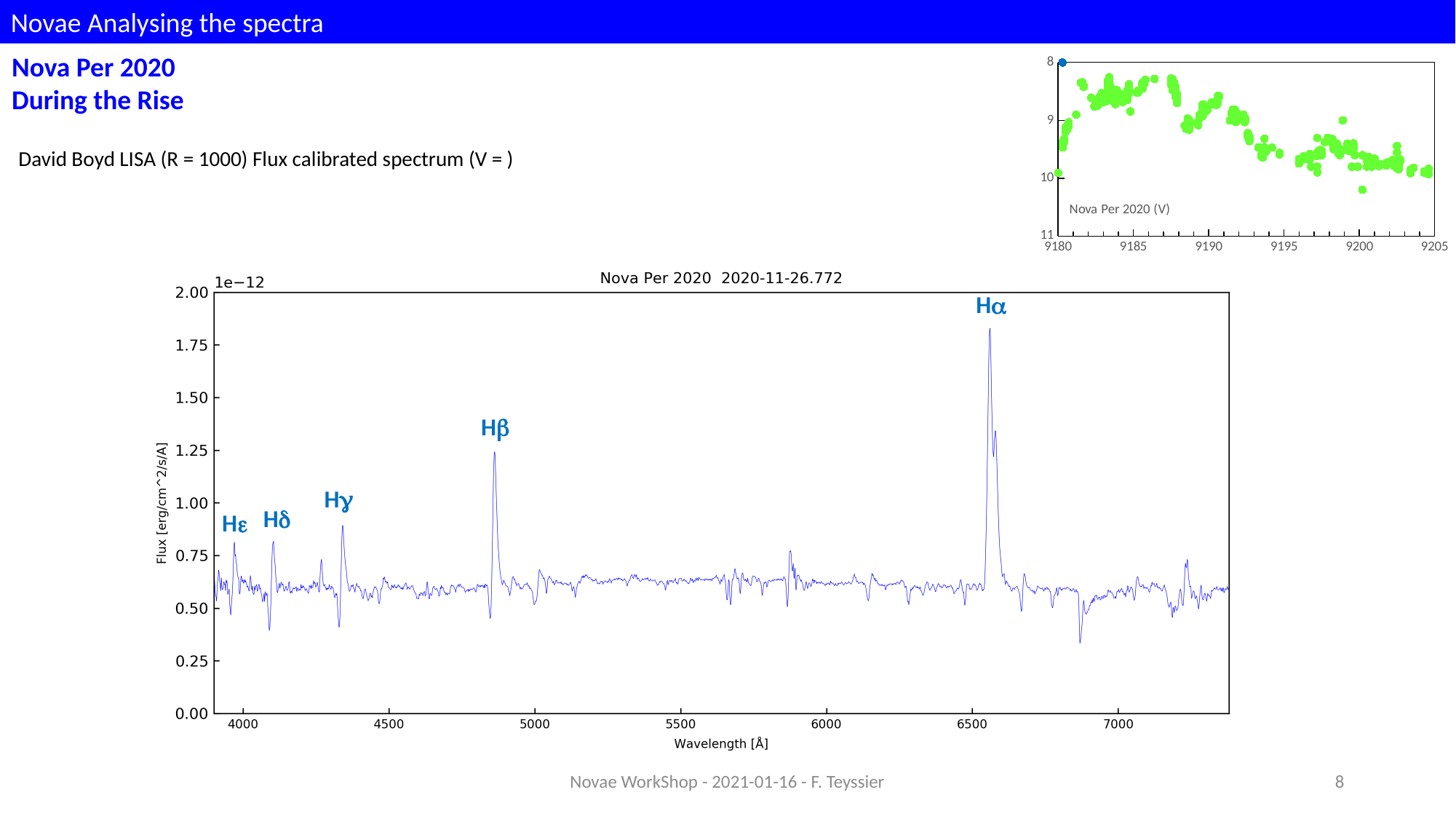
In the spectrum chart, is the peak flux of Hβ greater or less than 1.00 (×1e−12)? greater What type of chart is the small chart in the top right corner of the slide? scatter chart In the spectrum chart, is the peak flux of Hα greater or less than 1.50 (×1e−12)? greater What is the title of the large spectrum chart? Nova Per 2020 2020-11-26.772 What type of chart is the large chart at the bottom of the slide? line chart In the spectrum chart, what is the label of the x axis? Wavelength [Å] In the spectrum chart, which has the higher peak flux, Hβ or Hγ? Hβ In the spectrum chart, how many emission lines are labelled with blue text? 5 In the spectrum chart, is the peak flux of Hγ greater or less than 1.00 (×1e−12)? less In the spectrum chart, which labelled emission line has the highest peak flux? Hα